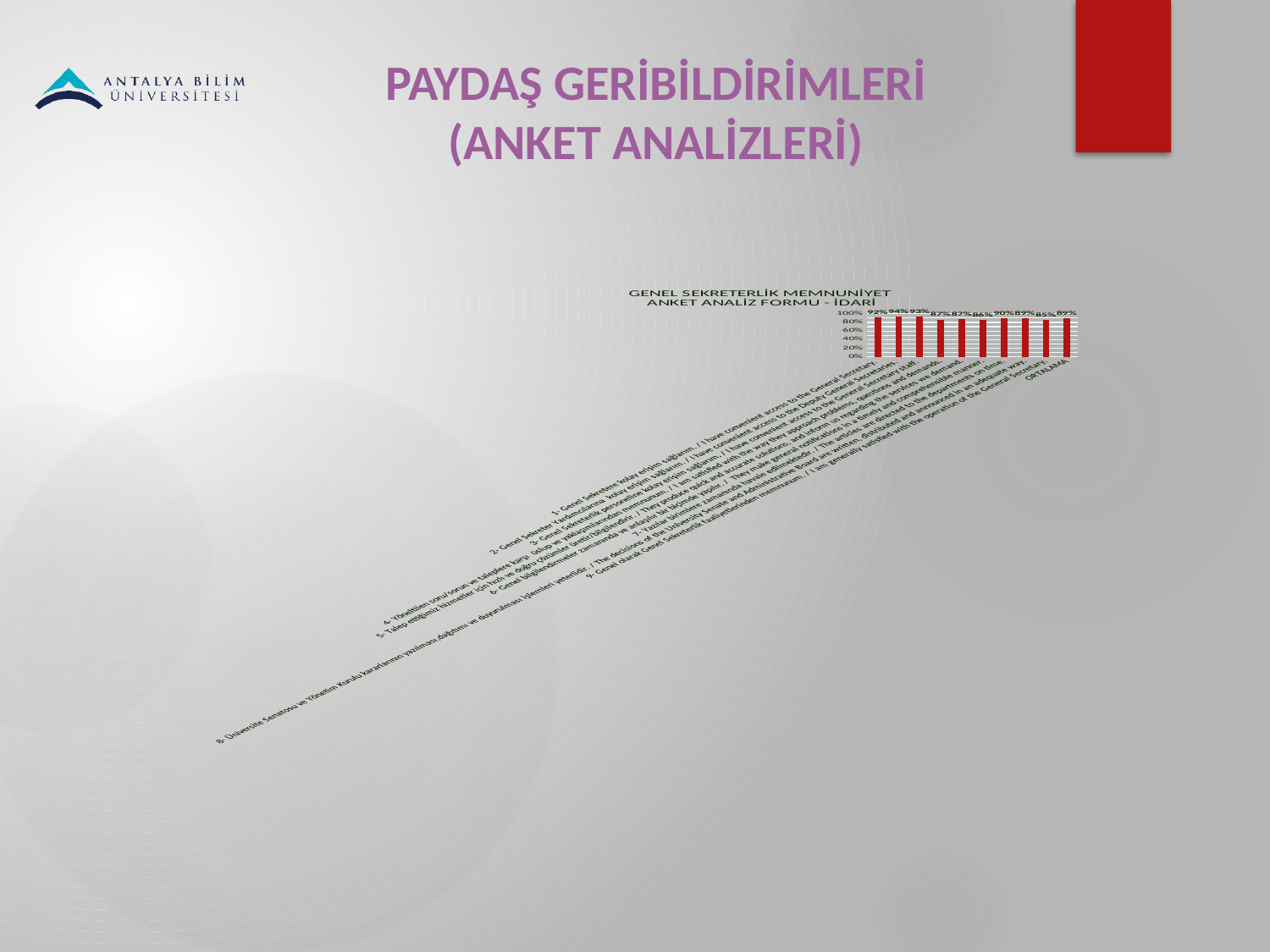
How many bars are plotted in the chart? 10 What is the maximum value shown on the chart's vertical axis? 100% What is the value of the ORTALAMA bar? 89% What is the value of the first bar (item 1) in the chart? 92% Which is larger: the value of the first bar (item 1) or the value of the ORTALAMA bar? the first bar (item 1) What kind of chart is shown on the slide? bar chart What is the difference between the highest value (94%) and the lowest value (85%) in the chart? 9 percentage points What is the lowest value shown in the chart? 85% What is the value of the second bar (item 2) in the chart? 94% What is the title of the chart? GENEL SEKRETERLİK MEMNUNİYET ANKET ANALİZ FORMU - İDARİ What is the highest value shown in the chart? 94% Is the value of the ORTALAMA bar greater or less than 80%? greater